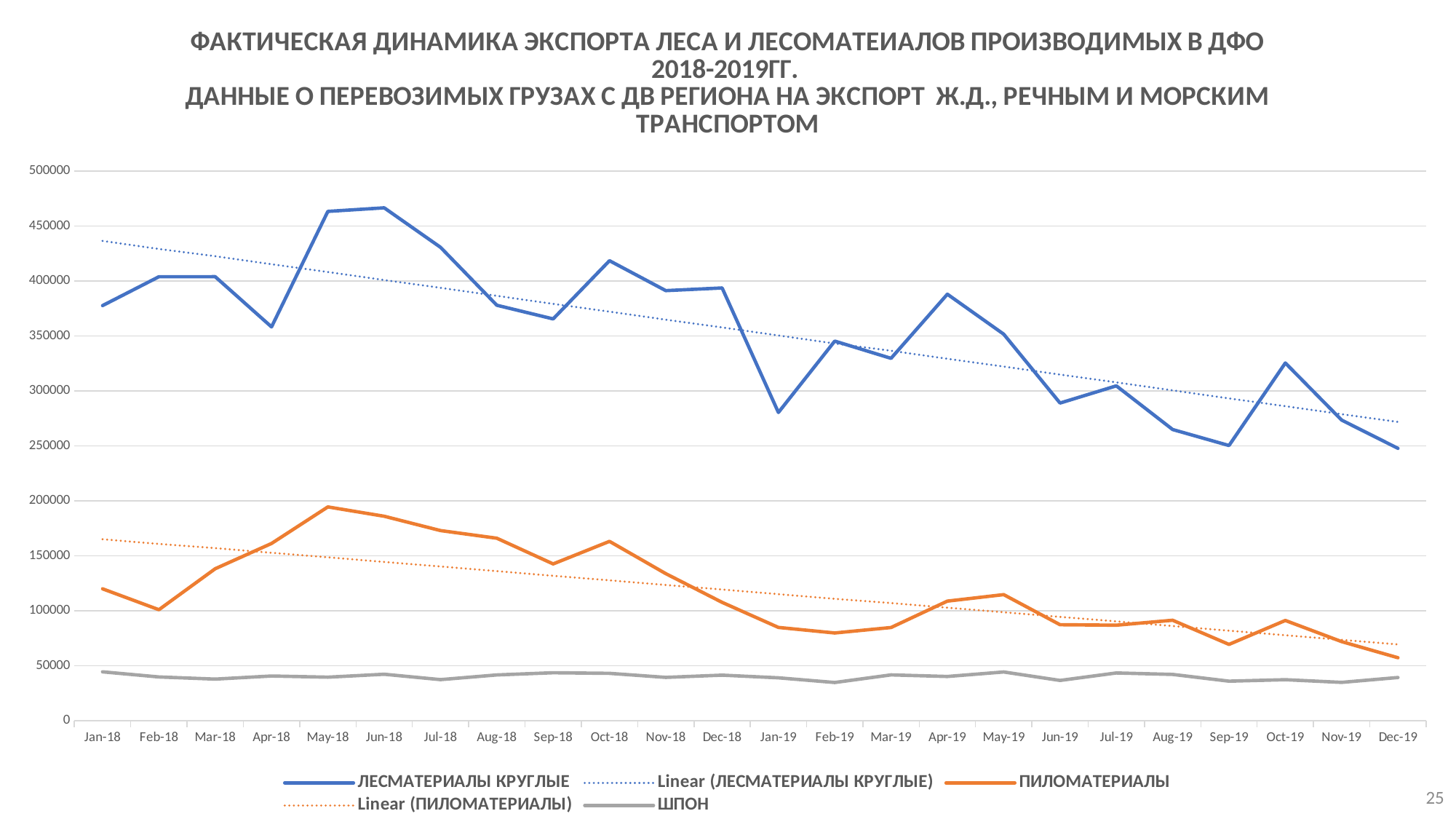
Which month has the highest value for ПИЛОМАТЕРИАЛЫ? May-18 Does the ЛЕСМАТЕРИАЛЫ КРУГЛЫЕ series generally rise or fall from Jan-18 to Dec-19? fall Which month has the lowest value for ПИЛОМАТЕРИАЛЫ? Dec-19 What kind of chart is shown on the slide? line chart Is the value for ШПОН in Jan-18 greater or less than 50000? less Which series is drawn with a grey line? ШПОН Is the value for ЛЕСМАТЕРИАЛЫ КРУГЛЫЕ in Jun-18 greater or less than 450000? greater How many months are plotted along the x axis? 24 Is the value for ЛЕСМАТЕРИАЛЫ КРУГЛЫЕ in Jan-19 greater or less than 300000? less How many entries does the legend list? 5 Which is larger in Dec-19: ЛЕСМАТЕРИАЛЫ КРУГЛЫЕ or ПИЛОМАТЕРИАЛЫ? ЛЕСМАТЕРИАЛЫ КРУГЛЫЕ